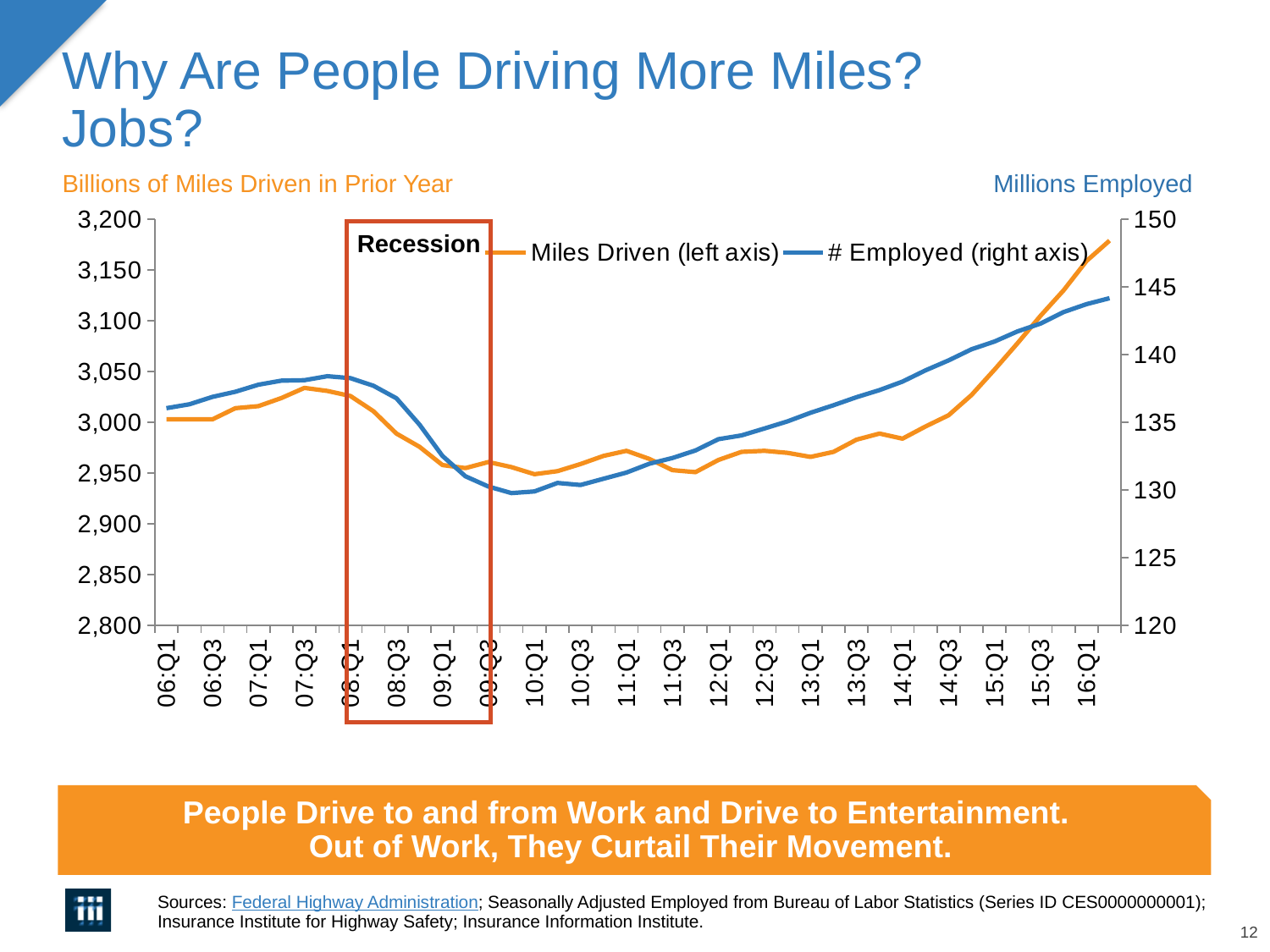
Is the value for Miles Driven at 09:Q3 greater or less than 3,000? less Is the value for # Employed at 10:Q1 greater or less than 135? less At which quarter does the # Employed series reach its highest value? 16:Q2 Is the value for # Employed at 16:Q1 greater or less than 140? greater What kind of chart is shown on the slide? Line chart How many series does the legend list? 2 How many quarter labels are shown on the x axis? 21 At which quarter does the Miles Driven series reach its highest value? 16:Q2 What are the two series named in the legend? Miles Driven (left axis) and # Employed (right axis) Does the # Employed series rise or fall between 08:Q1 and 09:Q3? Fall What label appears inside the red box on the chart? Recession